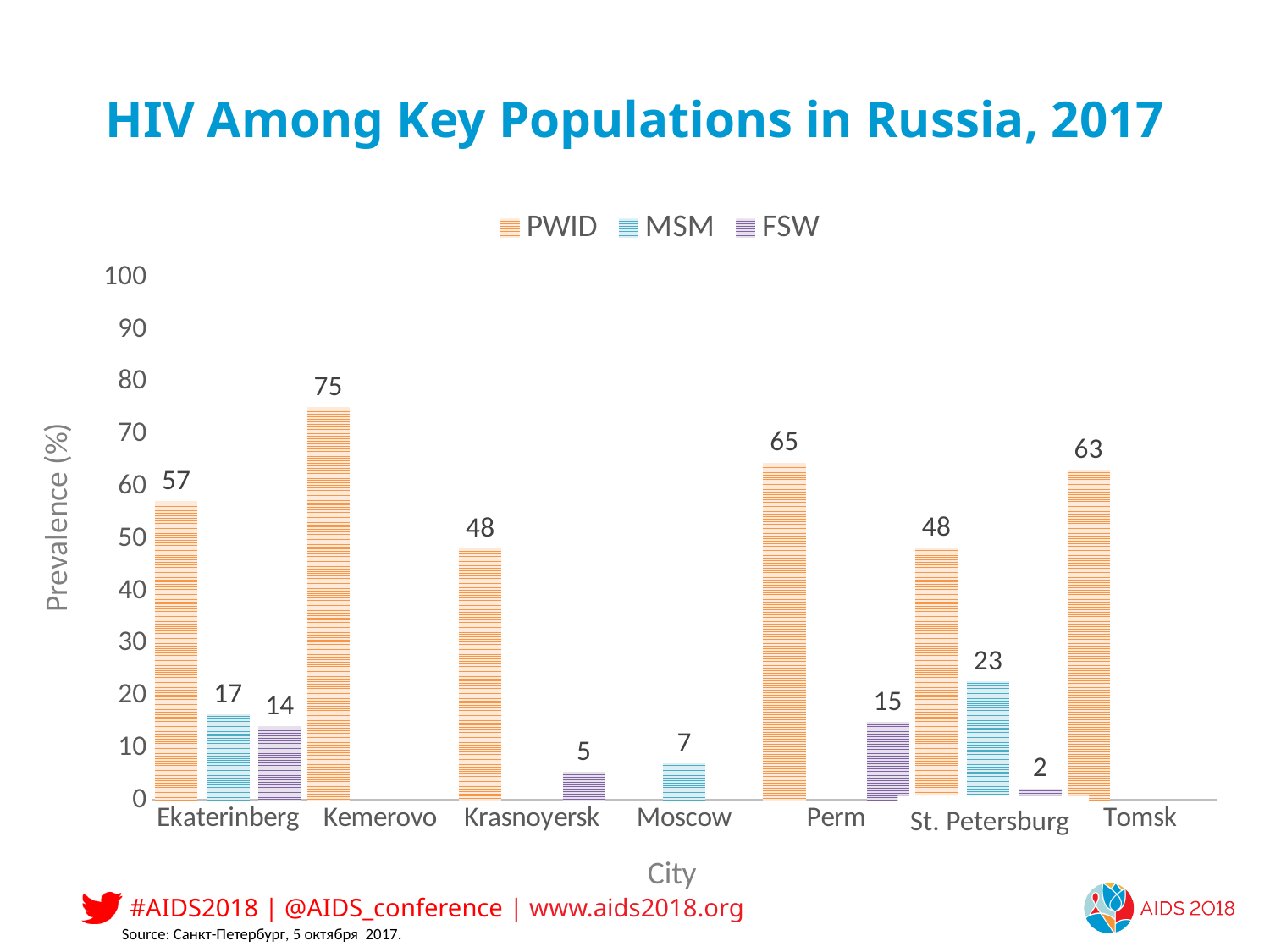
Which city has the lowest FSW value? St. Petersburg What is the difference between the PWID values for Perm and Tomsk? 2 What is the MSM value for St. Petersburg? 23 What is the title of the y axis? Prevalence (%) Which city has the highest PWID value? Kemerovo What kind of chart is shown on the slide? bar chart What is the PWID value for Kemerovo? 75 What is the FSW value for Ekaterinberg? 14 Which is larger, the PWID value for Ekaterinberg or for Tomsk? Tomsk What is the MSM value for Moscow? 7 How many cities are shown on the x axis? 7 How many series does the legend list? 3